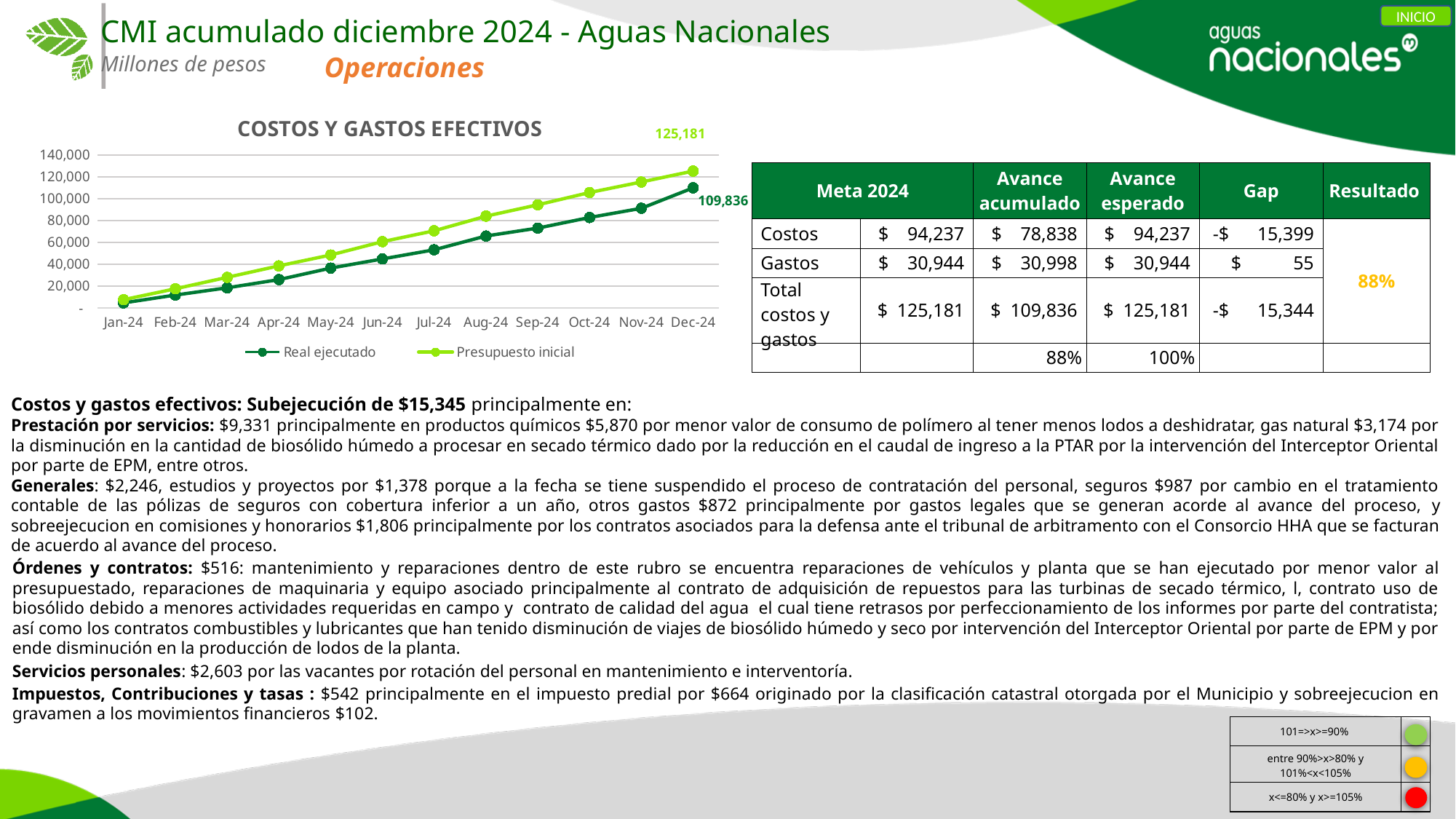
What are the two series named in the chart legend? Real ejecutado and Presupuesto inicial How many series does the chart legend list? 2 What is the difference between Presupuesto inicial and Real ejecutado in Dec-24? 15,345 Is the value for Real ejecutado in Sep-24 greater or less than 60,000? greater In Dec-24, which series has the larger value, Real ejecutado or Presupuesto inicial? Presupuesto inicial What is the title of the chart? COSTOS Y GASTOS EFECTIVOS What is the value of Real ejecutado in Dec-24? 109,836 What is the value of Presupuesto inicial in Dec-24? 125,181 Is the value for Presupuesto inicial in Jan-24 greater or less than 20,000? less How many months are plotted along the x axis of the chart? 12 Do the values of Real ejecutado rise or fall from Jan-24 to Dec-24? rise What kind of chart is shown on the slide? line chart